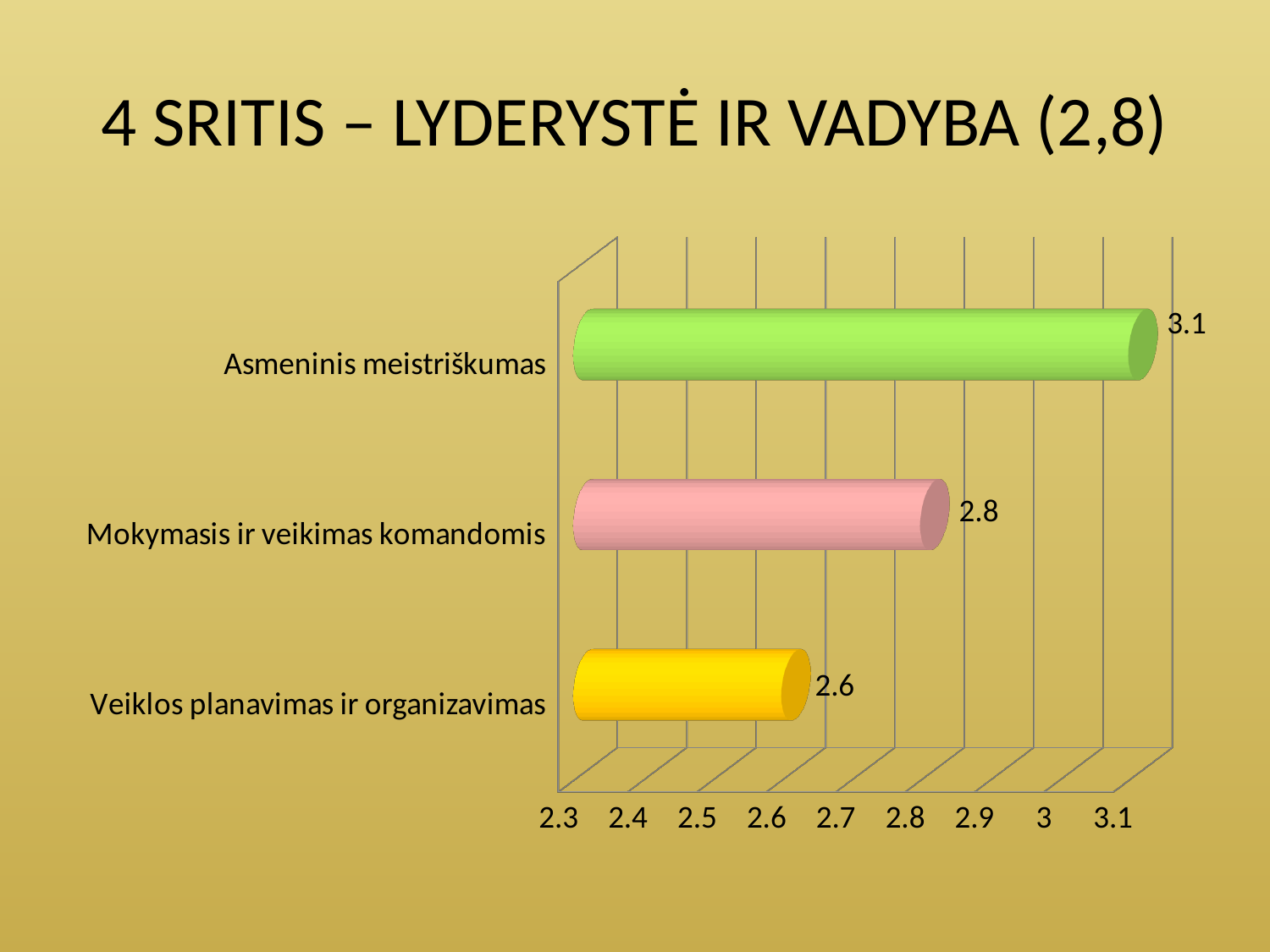
What is the difference between the values for Asmeninis meistriškumas and Veiklos planavimas ir organizavimas? 0.5 Which is larger, the value for Mokymasis ir veikimas komandomis or the value for Veiklos planavimas ir organizavimas? Mokymasis ir veikimas komandomis What is the value for Asmeninis meistriškumas? 3.1 Which category has the highest value? Asmeninis meistriškumas What is the title of the slide? 4 SRITIS – LYDERYSTĖ IR VADYBA (2,8) What kind of chart is shown on the slide? bar chart Which category has the lowest value? Veiklos planavimas ir organizavimas Is the value for Asmeninis meistriškumas greater or less than 3? greater How many categories are shown in the chart? 3 What is the value for Mokymasis ir veikimas komandomis? 2.8 What is the difference between the values for Mokymasis ir veikimas komandomis and Veiklos planavimas ir organizavimas? 0.2 What is the value for Veiklos planavimas ir organizavimas? 2.6